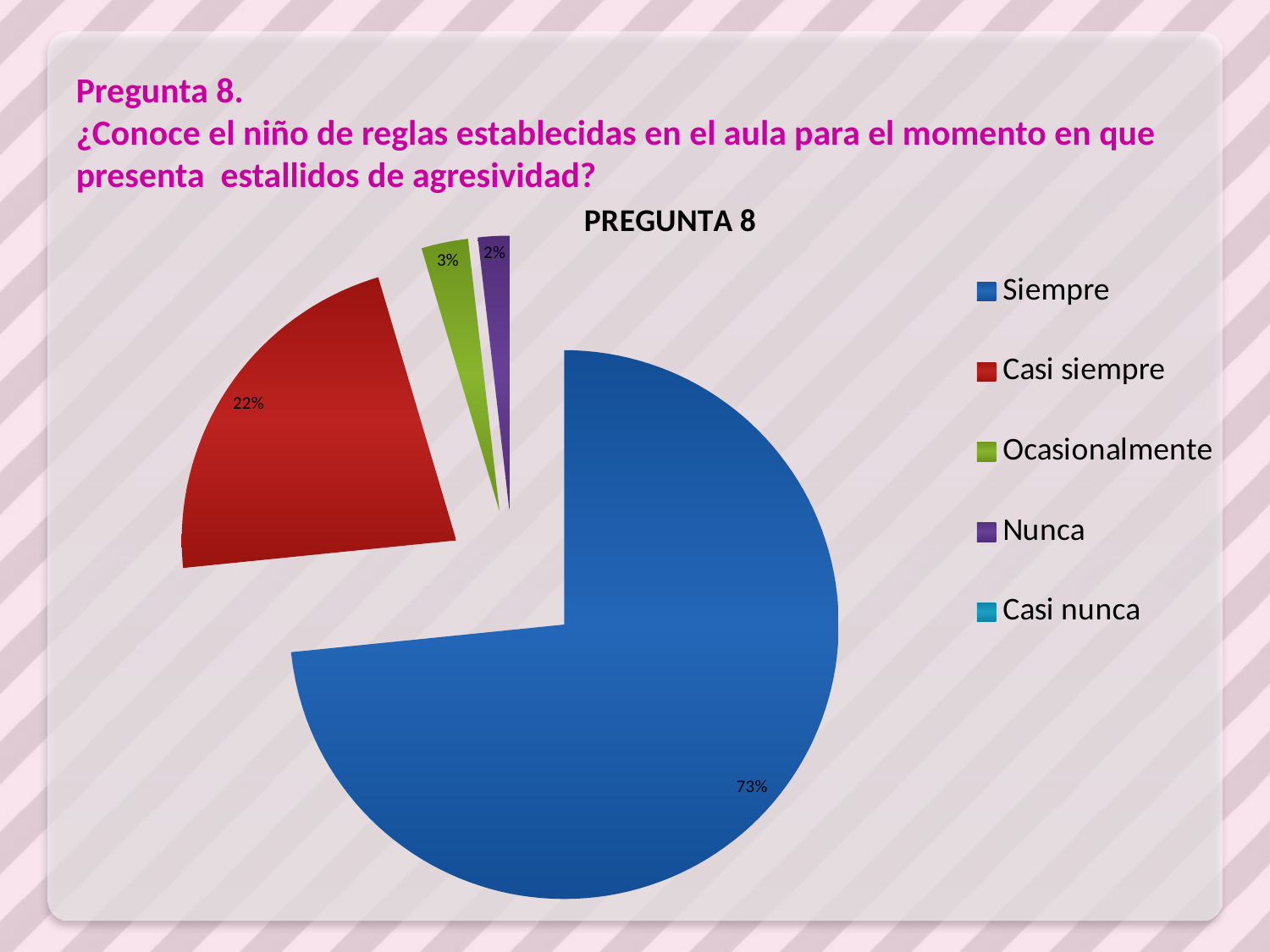
What percentage is shown for Nunca? 2% Which of the labelled slices has the smallest share of the pie? Nunca What is the difference in percentage points between Siempre and Casi siempre? 51 Which is larger, the share for Casi siempre or the share for Ocasionalmente? Casi siempre What percentage is shown for Ocasionalmente? 3% How many entries does the legend list? 5 What is the title of the chart? PREGUNTA 8 Which category has the largest share of the pie? Siempre What percentage of the pie does the Siempre slice represent? 73% What percentage is shown for Casi siempre? 22% What type of chart is shown on the slide? pie chart What colour is the Siempre slice? blue